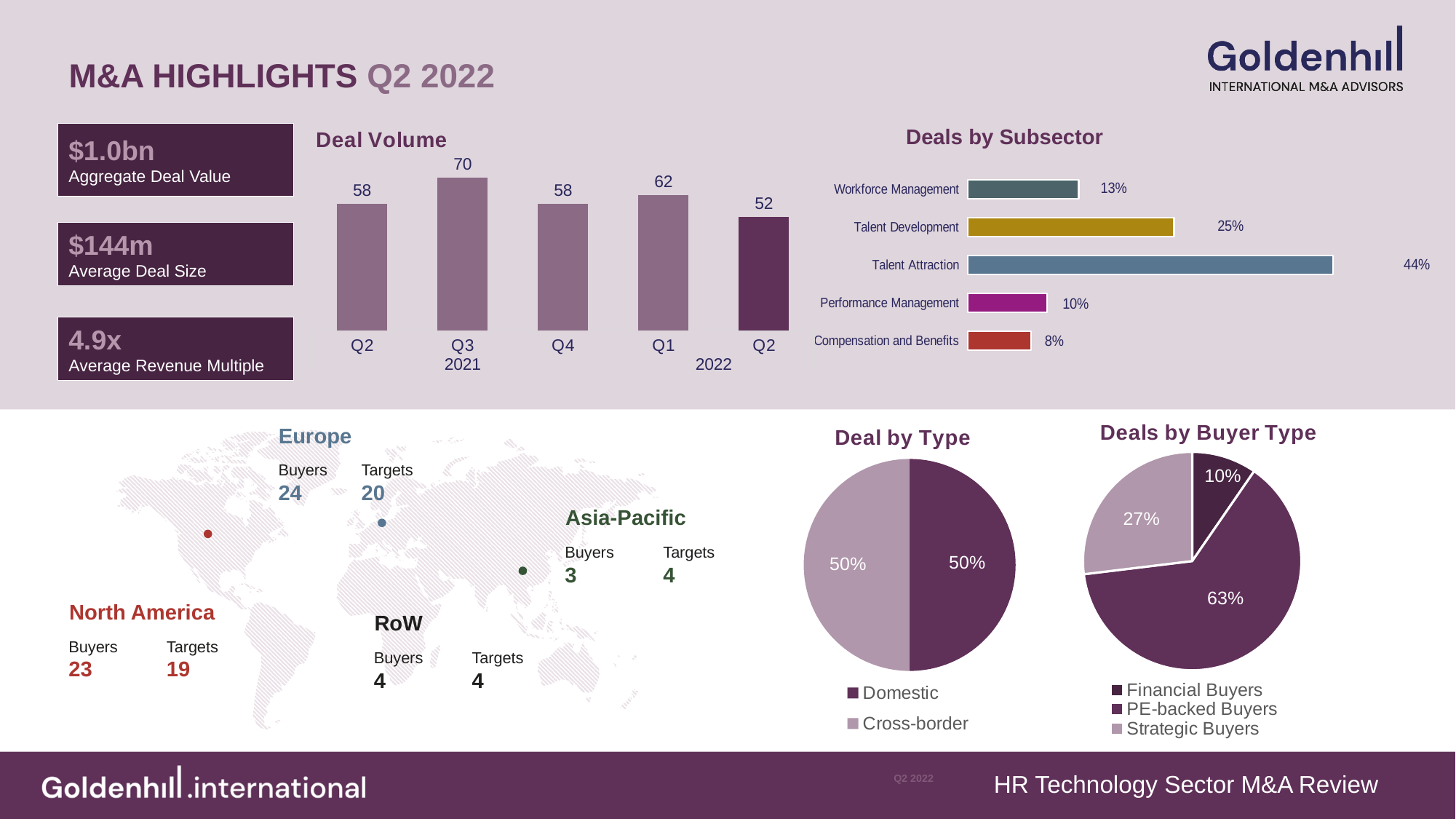
What type of chart is the Deal Volume chart? Bar chart In the Deal Volume chart, which quarter has the highest deal volume? Q3 2021 In the Deals by Buyer Type pie chart, which buyer type has the largest share? PE-backed Buyers In the Deal Volume chart, what is the deal volume for Q3 2021? 70 In the Deal Volume chart, what is the difference between the Q3 2021 and Q2 2022 deal volumes? 18 In the Deals by Subsector chart, what percentage is shown for Talent Development? 25% In the Deals by Subsector chart, which subsector has the smallest share? Compensation and Benefits How many quarters are shown in the Deal Volume chart? 5 In the Deal by Type pie chart, what share is Cross-border? 50% In the Deals by Subsector chart, which subsector has the largest share? Talent Attraction In the Deal Volume chart, which quarter has the lowest deal volume? Q2 2022 How many entries does the legend of the Deals by Buyer Type pie chart list? 3